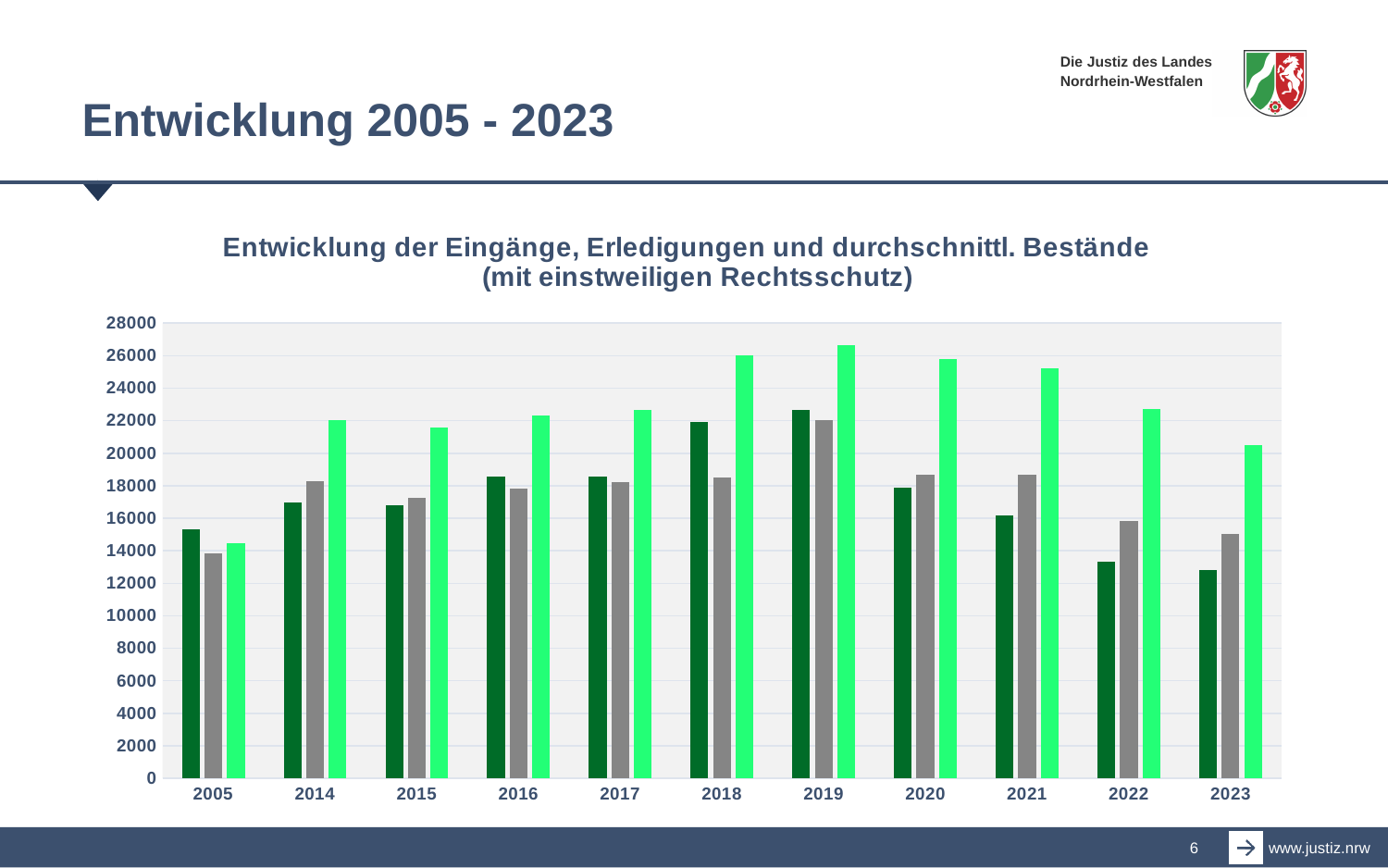
What kind of chart is shown on the slide? bar chart For 2023, which is larger: the dark green bar or the bright green bar? the bright green bar What is the title of the chart? Entwicklung der Eingänge, Erledigungen und durchschnittl. Bestände (mit einstweiligen Rechtsschutz) Do the bright green bars rise or fall from 2019 to 2023? fall How many years are shown on the x axis of the chart? 11 How many bars are plotted for each year in the chart? 3 Is the bright green bar for 2018 greater or less than 24000? greater In which year is the dark green bar the highest? 2019 In which year is the bright green bar the highest? 2019 Is the dark green bar for 2023 greater or less than 14000? less In which year is the bright green bar the lowest? 2005 In which year is the gray bar the lowest? 2005